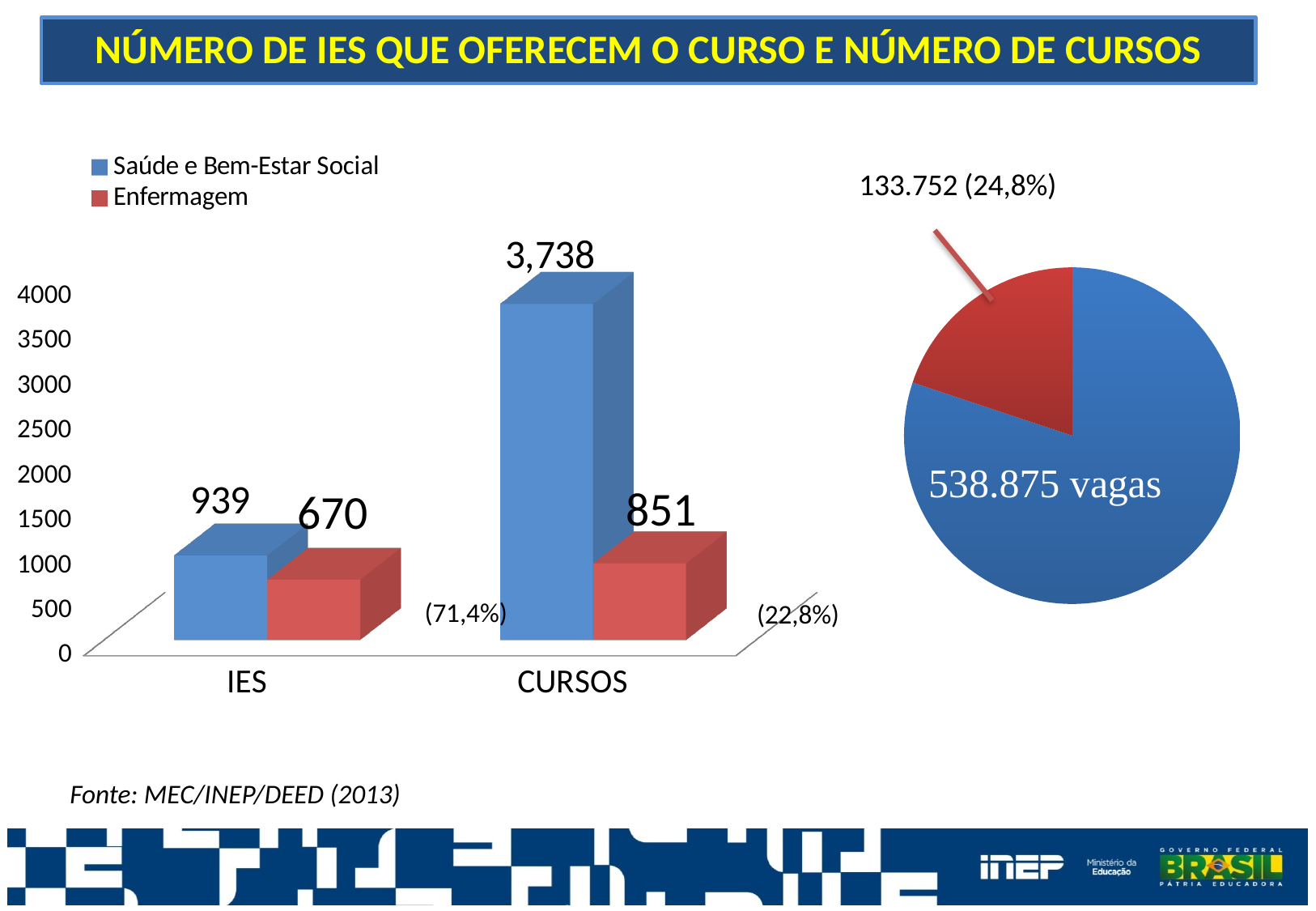
In the bar chart, what is the value for Enfermagem in the CURSOS category? 851 In the bar chart, what is the value for Saúde e Bem-Estar Social in the CURSOS category? 3,738 In the bar chart, what is the value for Enfermagem in the IES category? 670 What kind of chart is shown on the right side of the slide? Pie chart In the bar chart, what is the difference between the Saúde e Bem-Estar Social and Enfermagem values in the CURSOS category? 2,887 In the bar chart, which bar has the highest value? Saúde e Bem-Estar Social, CURSOS In the pie chart, what share does the red slice labelled 133.752 represent? 24,8% How many categories are shown on the x axis of the bar chart? 2 In the bar chart, which is larger: Enfermagem for IES or Enfermagem for CURSOS? Enfermagem for CURSOS How many series does the legend of the bar chart list? 2 In the bar chart, what is the difference between the Saúde e Bem-Estar Social and Enfermagem values in the IES category? 269 In the bar chart, what is the value for Saúde e Bem-Estar Social in the IES category? 939